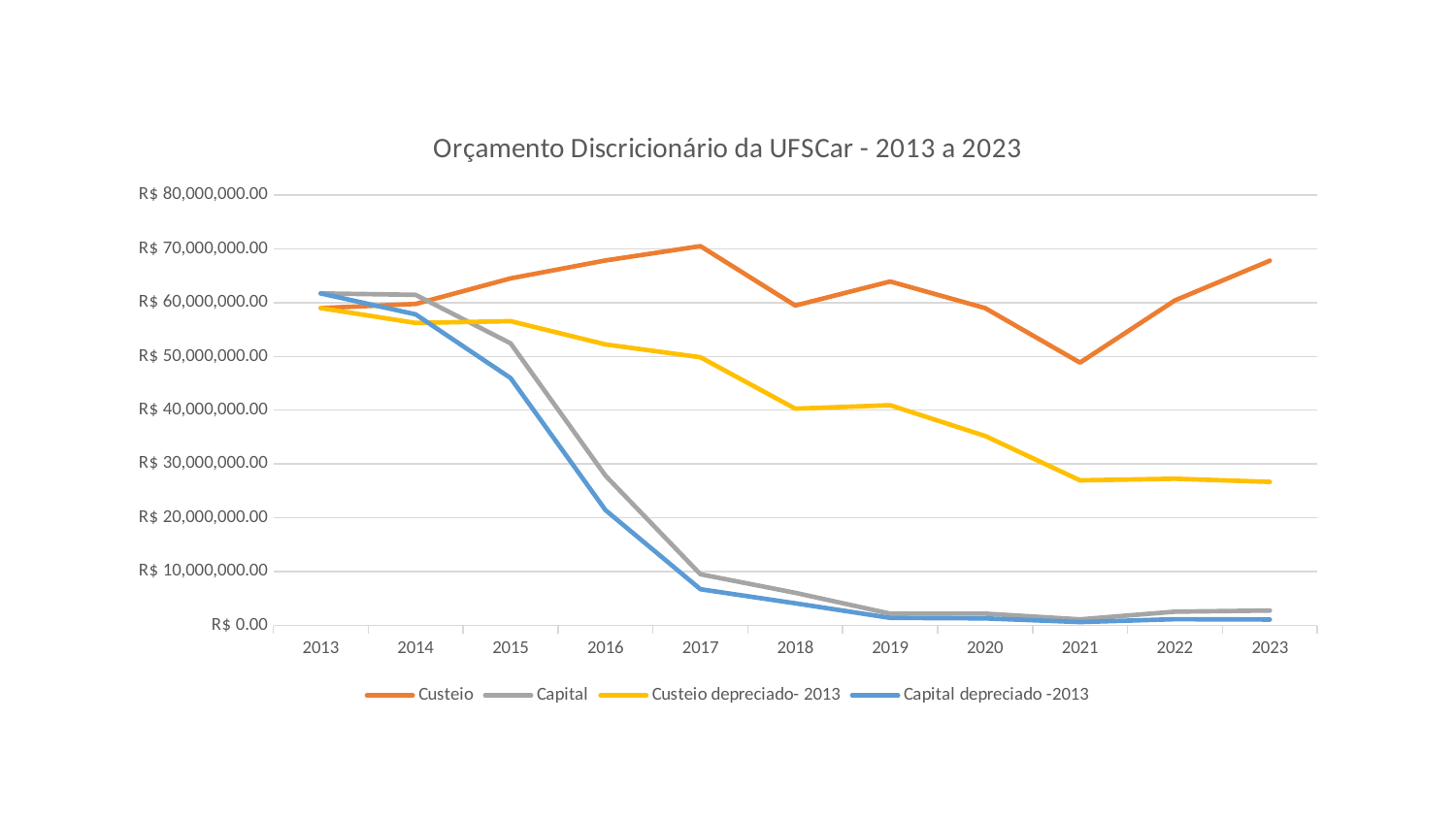
Is the value for Capital depreciado -2013 in 2016 greater or less than R$ 30,000,000.00? less In which year is the Custeio series at its lowest? 2021 What is the title of the chart? Orçamento Discricionário da UFSCar - 2013 a 2023 In 2019, which is larger: Custeio or Custeio depreciado- 2013? Custeio In which year is the Custeio series at its highest? 2017 How many series does the legend list? 4 Is the value for Custeio in 2021 greater or less than R$ 60,000,000.00? less Is the value for Capital in 2019 greater or less than R$ 10,000,000.00? less What kind of chart is shown on the slide? Line chart How many years are plotted along the x axis? 11 Does the Custeio depreciado- 2013 series rise or fall from 2013 to 2023? Fall